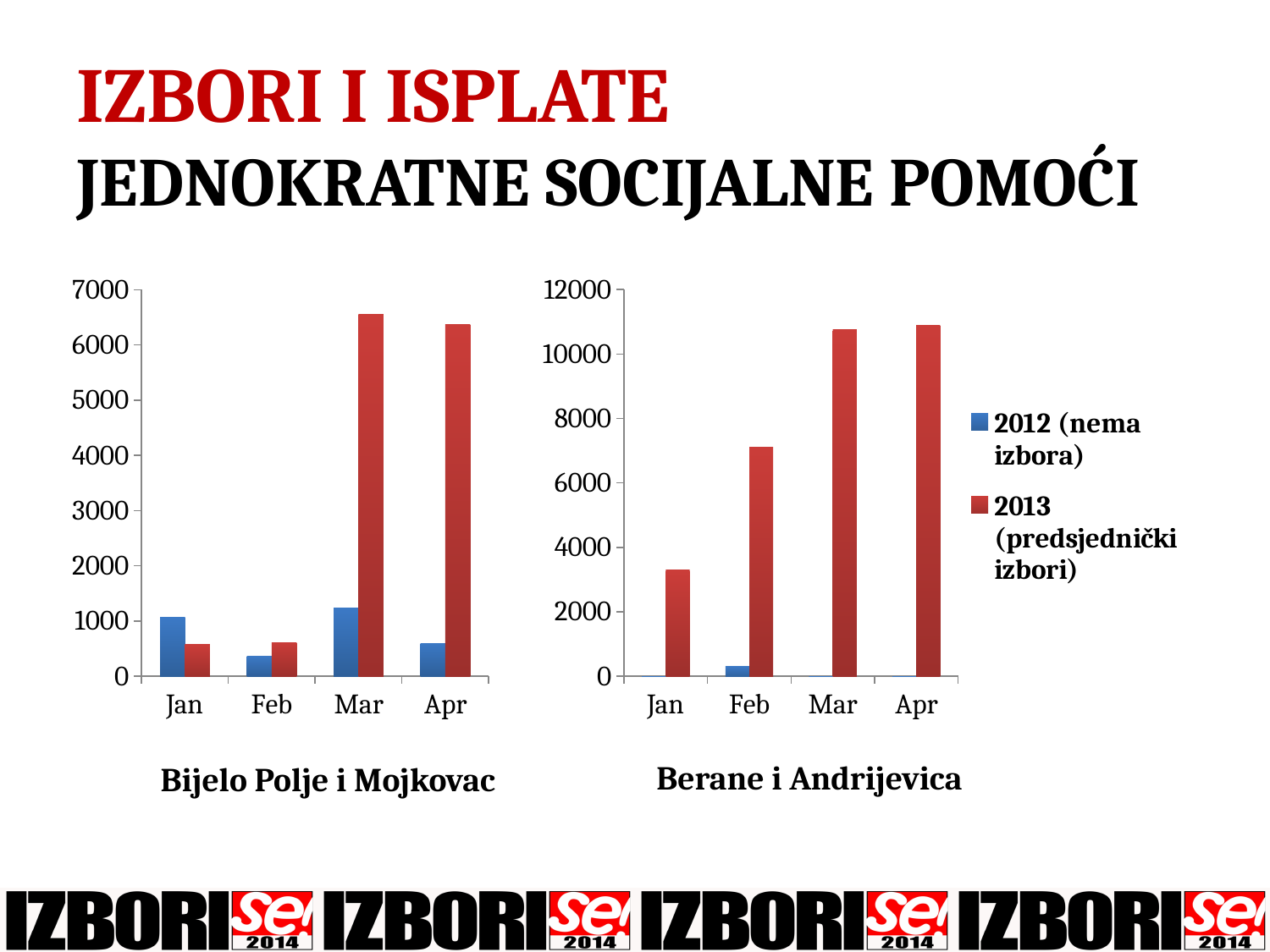
In the Bijelo Polje i Mojkovac chart, is the 2013 (predsjednički izbori) value for Mar greater or less than 6000? greater In the Bijelo Polje i Mojkovac chart, which series has the larger value for Jan, 2012 (nema izbora) or 2013 (predsjednički izbori)? 2012 (nema izbora) In the Berane i Andrijevica chart, which month has the lowest value for 2013 (predsjednički izbori)? Jan In the Bijelo Polje i Mojkovac chart, which month has the highest value for 2013 (predsjednički izbori)? Mar How many months are shown on the x axis of the Berane i Andrijevica chart? 4 In the Berane i Andrijevica chart, do the 2013 (predsjednički izbori) values rise or fall from Jan to Apr? rise What kind of chart is the Bijelo Polje i Mojkovac chart? bar chart What colour are the bars for the 2013 (predsjednički izbori) series? red How many series does the legend list? 2 In the Berane i Andrijevica chart, is the 2013 (predsjednički izbori) value for Feb greater or less than 6000? greater In the Bijelo Polje i Mojkovac chart, which series has the larger value for Mar, 2012 (nema izbora) or 2013 (predsjednički izbori)? 2013 (predsjednički izbori) In the Berane i Andrijevica chart, is the 2013 (predsjednički izbori) value for Jan greater or less than 4000? less